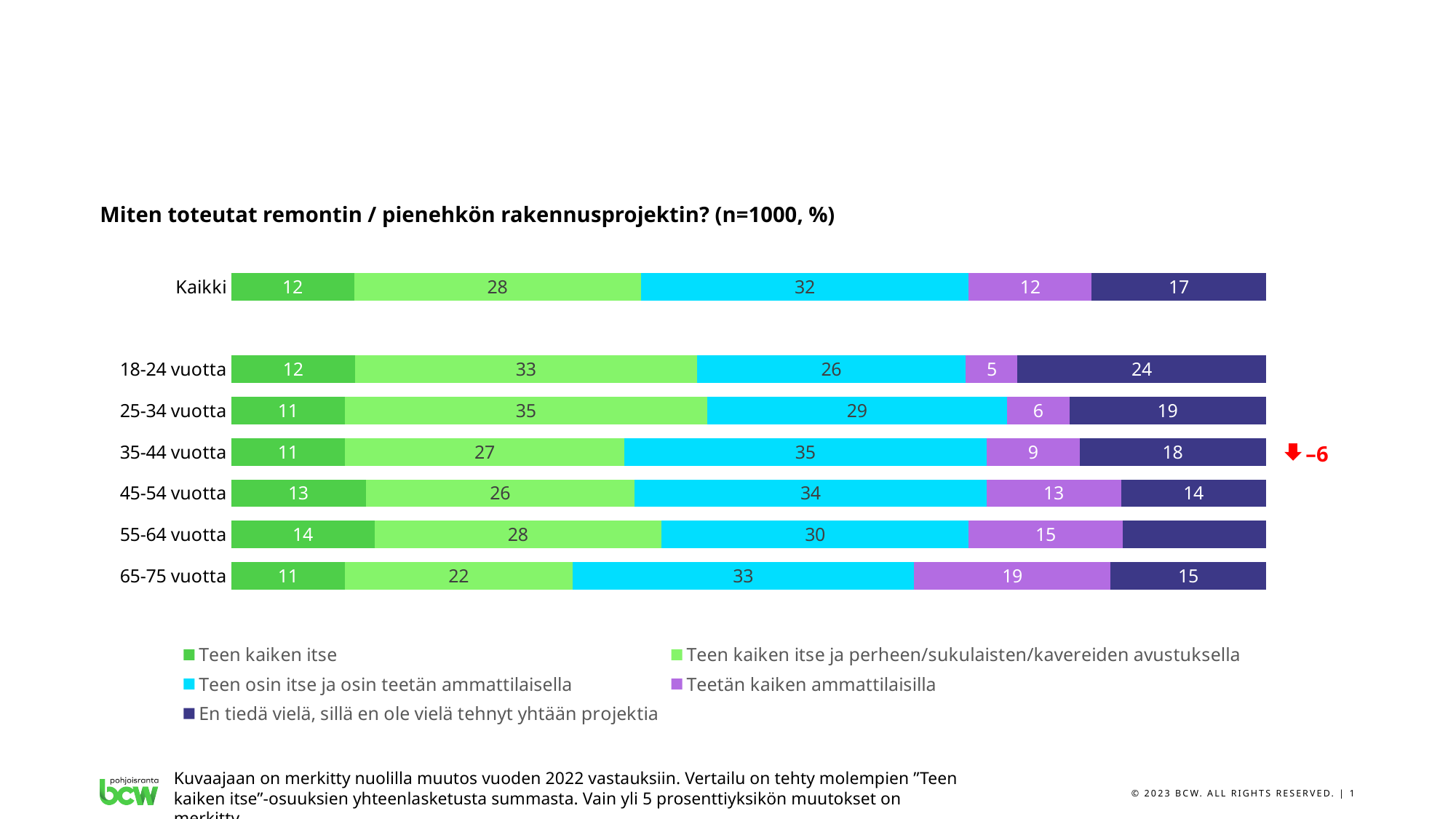
How many age groups (excluding Kaikki) are shown in the chart? 6 What is the value of "Teetän kaiken ammattilaisilla" for 65-75 vuotta? 19 What is the difference between the "Teen kaiken itse ja perheen/sukulaisten/kavereiden avustuksella" values for 25-34 vuotta and 65-75 vuotta? 13 Which age group is marked with a red arrow and the change "–6"? 35-44 vuotta How many series does the legend list? 5 Which age group has the highest value for "Teen kaiken itse"? 55-64 vuotta What is the value of "En tiedä vielä, sillä en ole vielä tehnyt yhtään projektia" for 18-24 vuotta? 24 Which age group has the lowest value for "Teetän kaiken ammattilaisilla"? 18-24 vuotta What is the total of the "Teen kaiken itse" and "Teen kaiken itse ja perheen/sukulaisten/kavereiden avustuksella" values for 45-54 vuotta? 39 What is the value of "Teen osin itse ja osin teetän ammattilaisella" for Kaikki? 32 What kind of chart is shown on the slide? Stacked bar chart Which is larger: the "Teen osin itse ja osin teetän ammattilaisella" value for 35-44 vuotta or for 18-24 vuotta? 35-44 vuotta